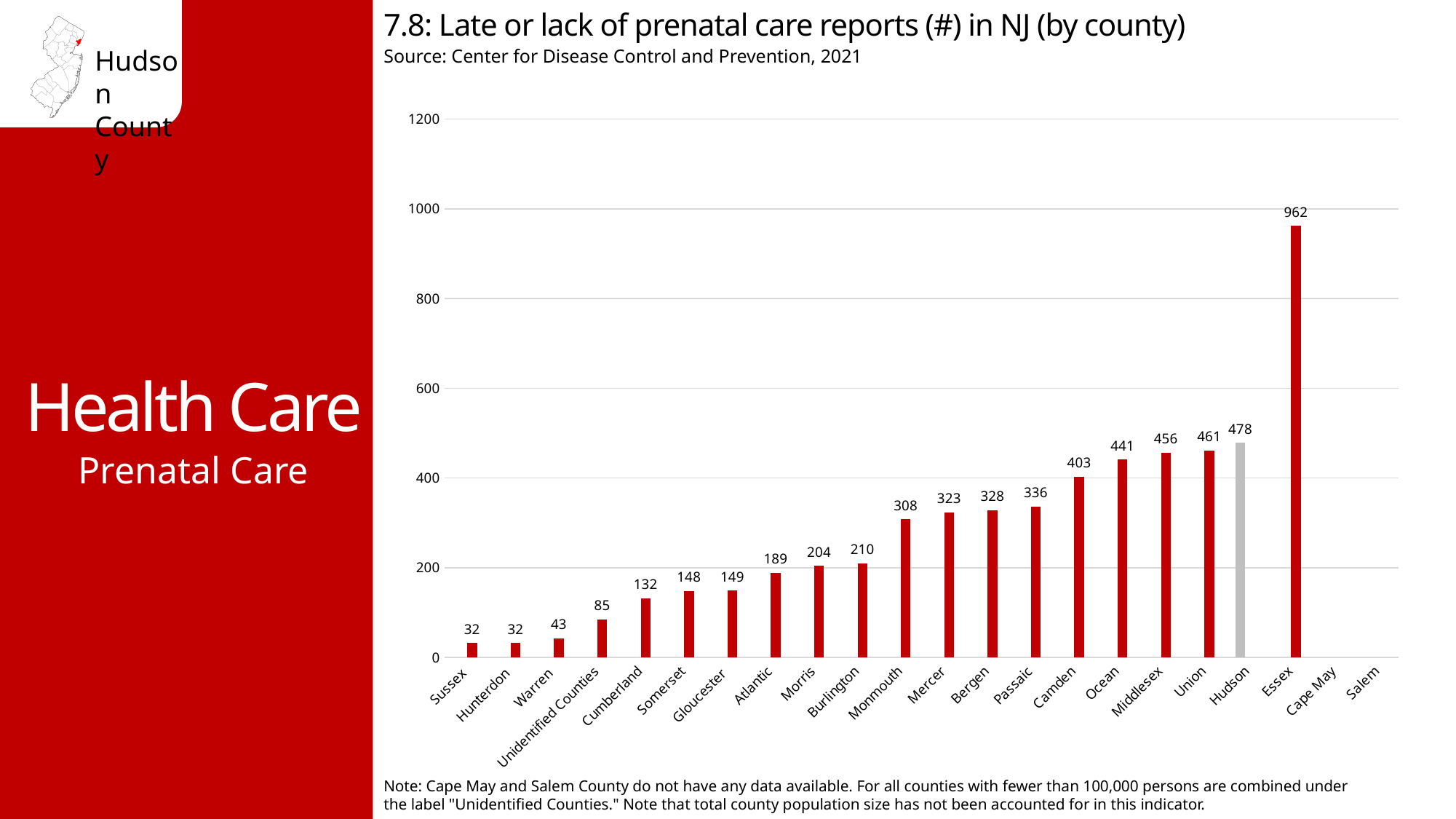
What is the value for Cumberland in the chart? 132 What is the difference between the values for Essex and Hudson? 484 What is the value for Essex in the chart? 962 How many categories are listed along the x axis of the chart? 22 Which county's bar is coloured gray instead of red? Hudson Is the value for Monmouth greater or less than 400? less Which county has the highest number of late or lack of prenatal care reports? Essex Do the bar values rise or fall from Sussex to Essex along the x axis? rise What is the value for Hudson in the chart? 478 Which has a larger value, Camden or Ocean? Ocean What is the difference between the values for Bergen and Mercer? 5 What kind of chart is shown on the slide? bar chart